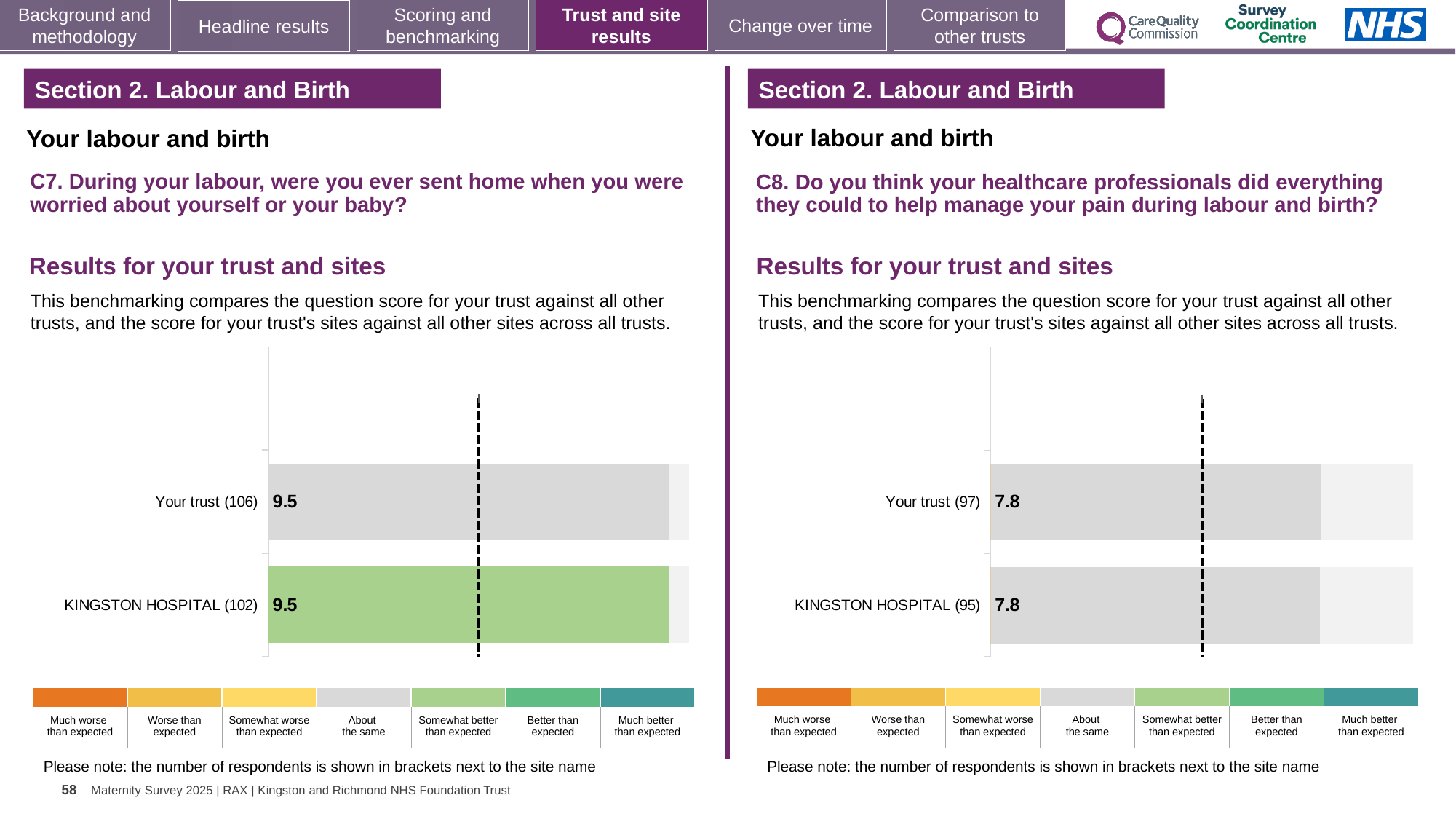
What kind of chart is used for the C7 results on the left? Bar chart On the C7 chart (left), what is the score for KINGSTON HOSPITAL? 9.5 On the C7 chart (left), what is the score for Your trust? 9.5 On the C8 chart (right), what is the difference between the score for Your trust and the score for KINGSTON HOSPITAL? 0 How many bars are plotted on the C8 chart (right)? 2 On the C8 chart (right), what is the score for Your trust? 7.8 On the C8 chart (right), what is the score for KINGSTON HOSPITAL? 7.8 On the C7 chart (left), which benchmark category does the green colour of the KINGSTON HOSPITAL bar correspond to in the key? Somewhat better than expected How many bars are plotted on the C7 chart (left)? 2 On the C8 chart (right), how many respondents are shown in brackets for Your trust? 97 On the C7 chart (left), how many respondents are shown in brackets for KINGSTON HOSPITAL? 102 On the C7 chart (left), what is the difference between the score for Your trust and the score for KINGSTON HOSPITAL? 0